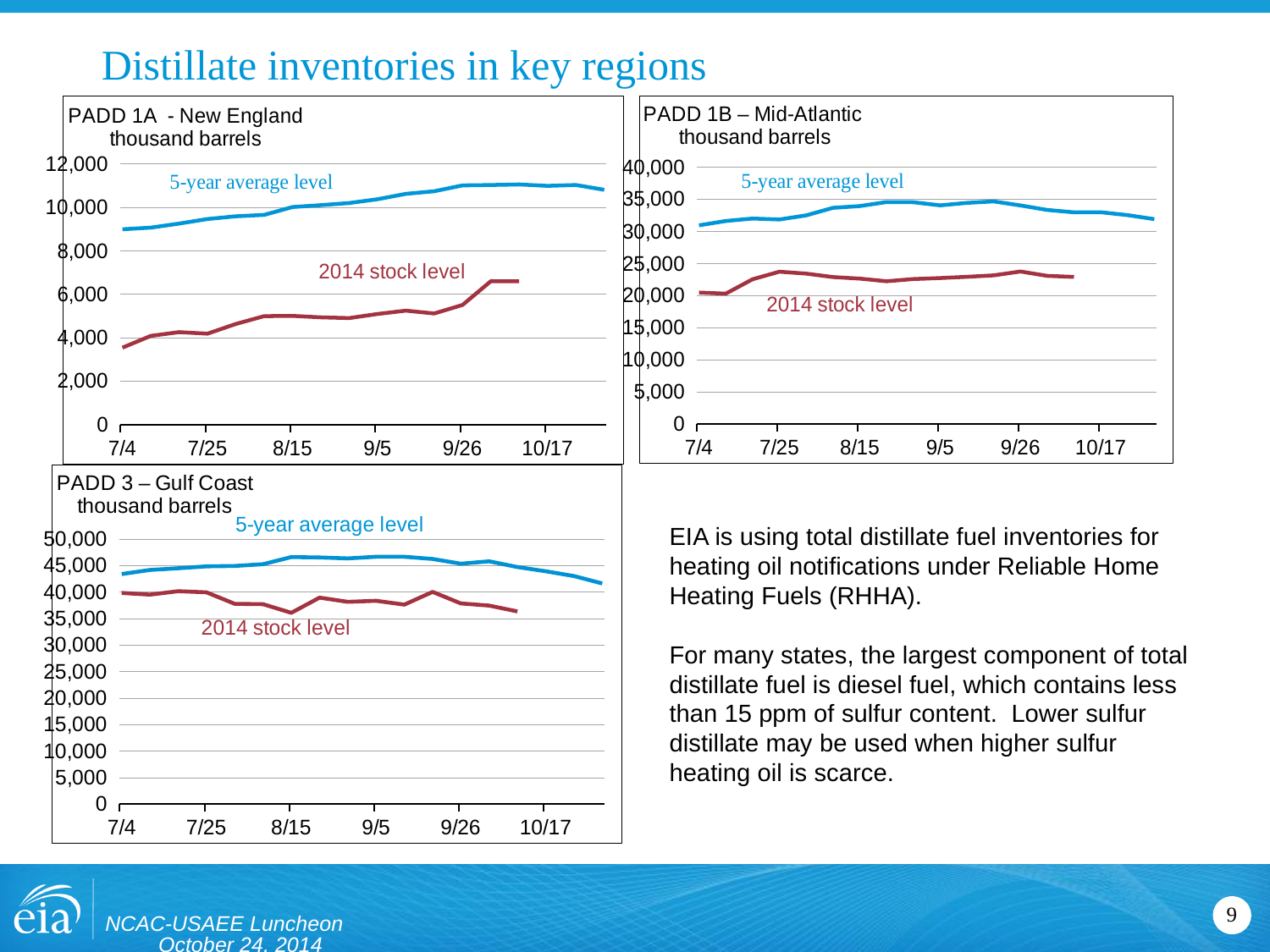
What unit is shown on the vertical axis of the PADD 3 – Gulf Coast chart? thousand barrels In the PADD 1A - New England chart, which series is higher throughout, the 5-year average level or the 2014 stock level? 5-year average level In the PADD 1A - New England chart, is the 5-year average level at 9/26 greater or less than 10,000? greater What kind of chart is the PADD 1A - New England chart? line chart How many series are plotted in the PADD 1B – Mid-Atlantic chart? 2 How many charts are shown on the slide? 3 In the PADD 1B – Mid-Atlantic chart, is the 5-year average level at 7/4 greater or less than 30,000? greater In the PADD 3 – Gulf Coast chart, does the 2014 stock level generally rise or fall from 7/4 to its last point? fall In the PADD 1B – Mid-Atlantic chart, is the 2014 stock level at 7/25 greater or less than 25,000? less In the PADD 1A - New England chart, does the 2014 stock level generally rise or fall from 7/4 to its last point? rise